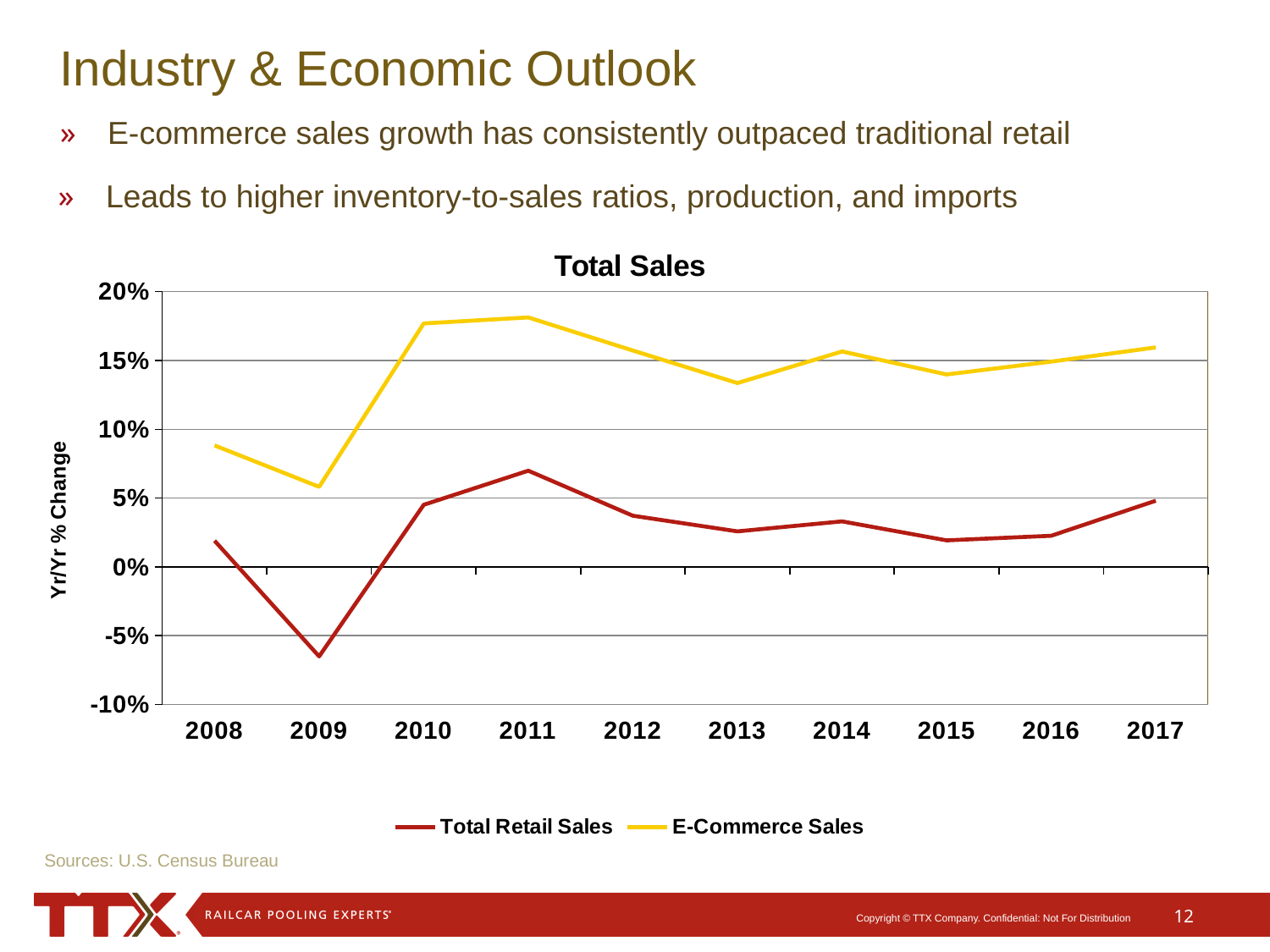
What kind of chart is shown on the slide? Line chart How many years are plotted along the x axis of the Total Sales chart? 10 In which year is the Total Retail Sales line at its highest? 2011 Is the value for E-Commerce Sales in 2008 greater or less than 10%? less In which year is the Total Retail Sales line at its lowest? 2009 In which year is the E-Commerce Sales line at its lowest? 2009 How many series does the legend of the Total Sales chart list? 2 Does the E-Commerce Sales line rise or fall from 2009 to 2010? Rise Is the value for E-Commerce Sales in 2010 greater or less than 15%? greater In 2017, which series has the larger value, Total Retail Sales or E-Commerce Sales? E-Commerce Sales What is the label on the y axis of the chart? Yr/Yr % Change Is the value for Total Retail Sales in 2009 greater or less than 0%? less